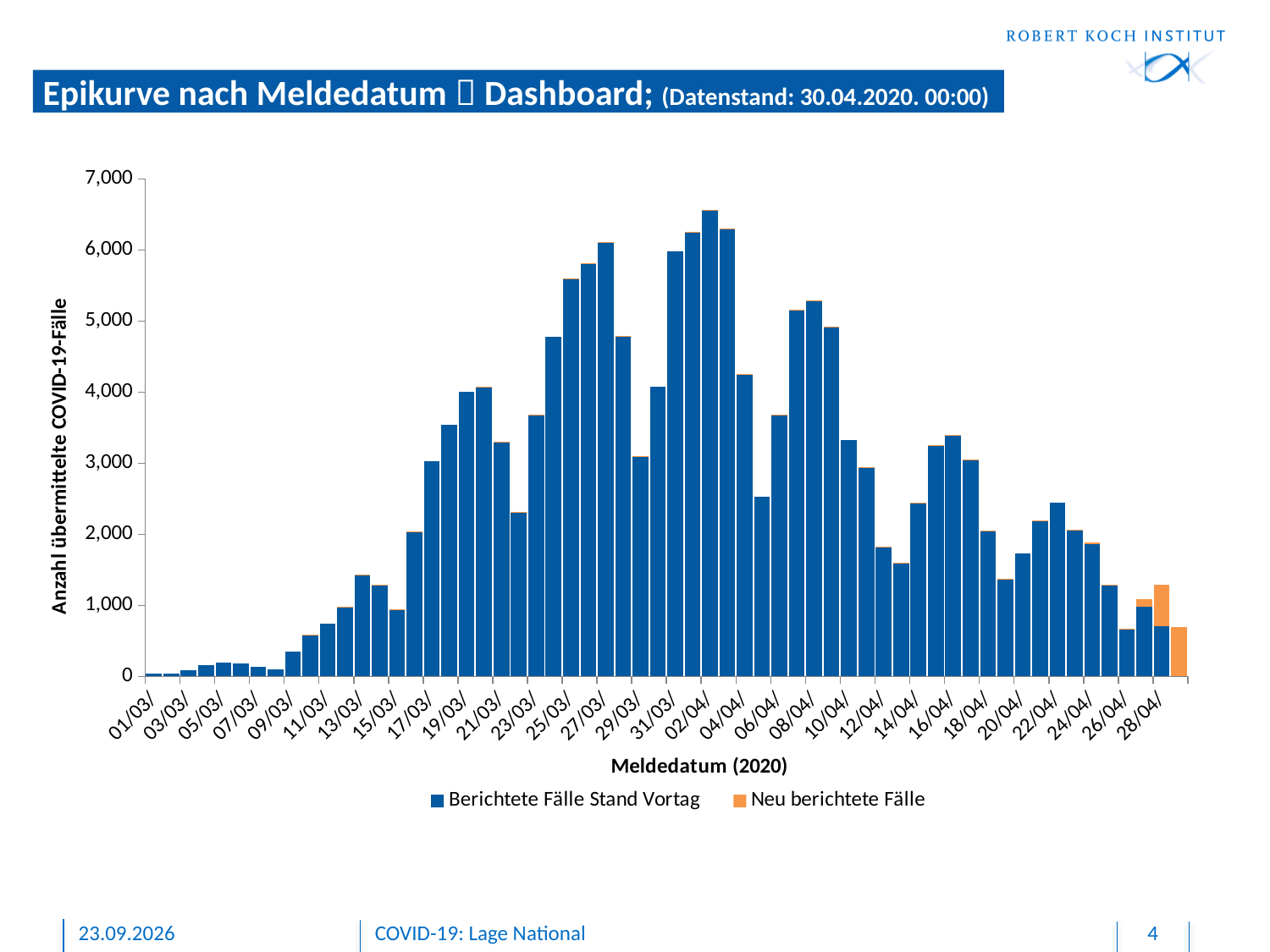
Which is larger, the bar for 19/03/ or the bar for 29/03/? 19/03/ What kind of chart is shown on the slide? Bar chart How many series does the legend list? 2 What are the two series named in the legend? Berichtete Fälle Stand Vortag; Neu berichtete Fälle Is the value for 25/03/ greater or less than 5,000? greater Is the value for 26/04/ greater or less than 1,000? less Is the value for 22/03/ greater or less than 3,000? less What is the title of the y-axis? Anzahl übermittelte COVID-19-Fälle Do the bars rise or fall from 02/04/ to 05/04/? fall Which reporting date has the highest bar? 02/04/